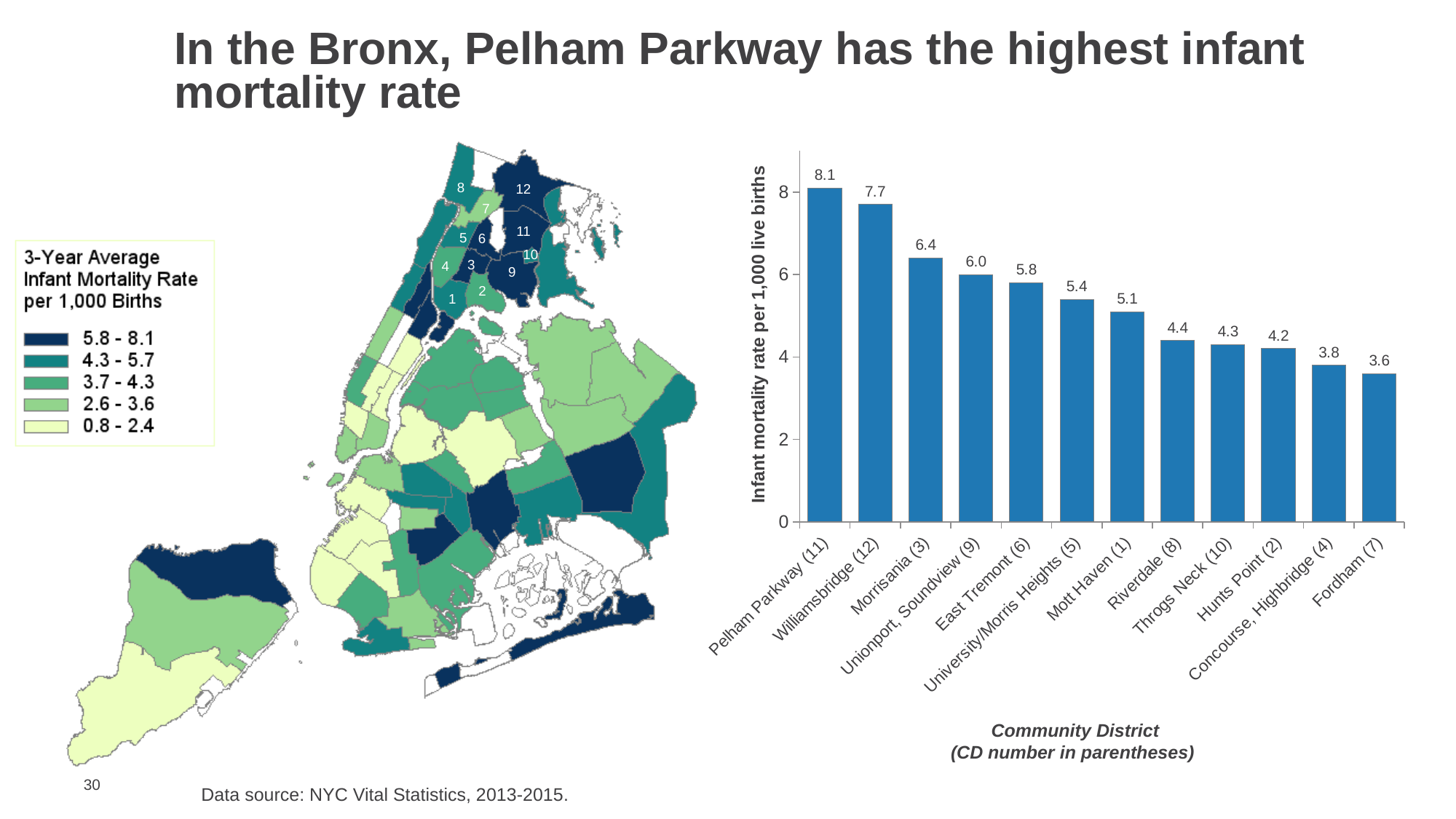
What kind of chart is used to show infant mortality rates by community district? Bar chart What is the difference in infant mortality rate between Pelham Parkway (11) and Williamsbridge (12)? 0.4 How many community districts are shown in the bar chart? 12 Is the infant mortality rate for Unionport, Soundview (9) greater or less than 4? greater What is the difference in infant mortality rate between Mott Haven (1) and Fordham (7)? 1.5 Do the values in the bar chart rise or fall from left to right? Fall What is the infant mortality rate for Morrisania (3)? 6.4 Which has a higher infant mortality rate, East Tremont (6) or Riverdale (8)? East Tremont (6) What is the infant mortality rate for Pelham Parkway (11)? 8.1 Which community district has the highest infant mortality rate in the bar chart? Pelham Parkway (11) What is the infant mortality rate for Throgs Neck (10)? 4.3 Which community district has the lowest infant mortality rate in the bar chart? Fordham (7)